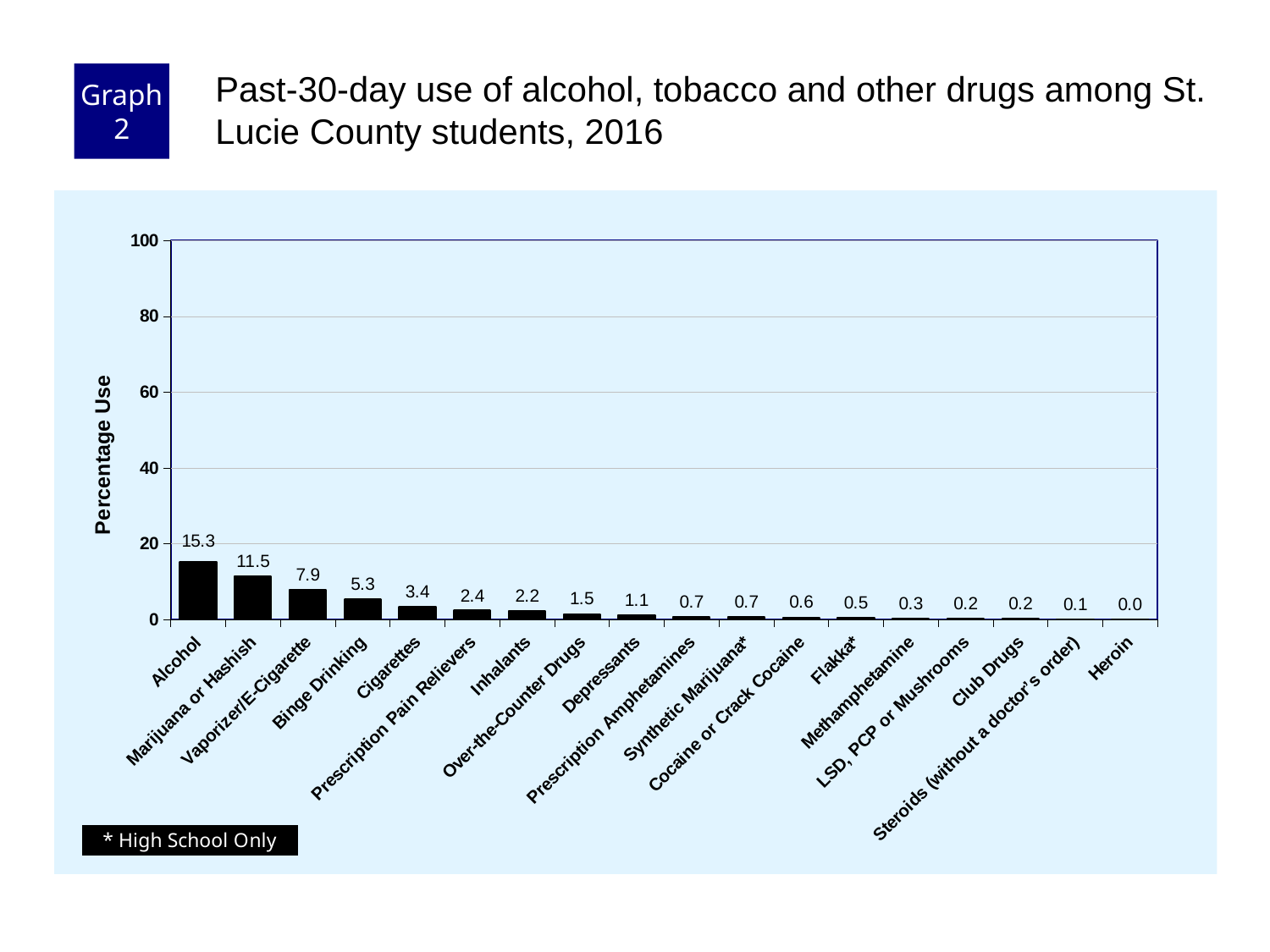
What is the percentage use for Cigarettes? 3.4 What is the label of the y axis? Percentage Use Which has a higher percentage use, Binge Drinking or Cigarettes? Binge Drinking Which category has the highest percentage use? Alcohol What is the difference in percentage use between Alcohol and Marijuana or Hashish? 3.8 What is the percentage use for Heroin? 0.0 How many categories are shown on the x axis? 18 Is the value for Alcohol greater or less than 20? less What kind of chart is shown on the slide? Bar chart What is the percentage use for Vaporizer/E-Cigarette? 7.9 What is the percentage use for Alcohol? 15.3 Which category has the lowest percentage use? Heroin